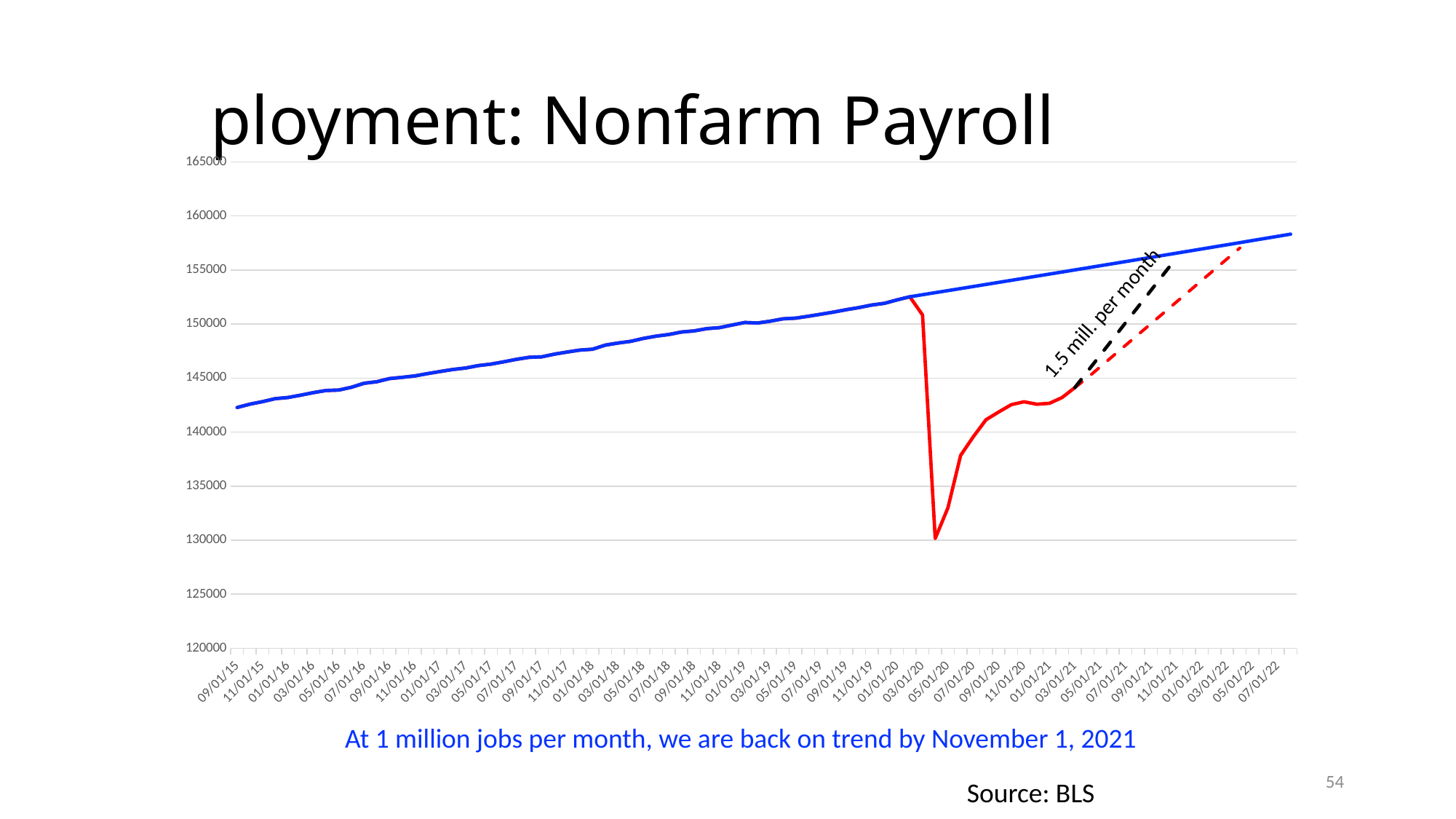
What source is cited below the chart? BLS Is the value of the red line at 01/01/21 greater or less than 145000? less Is the value of the blue line at 09/01/15 greater or less than 145000? less Which line reaches the lowest value on the chart, the blue line or the red line? the red line Does the blue line rise or fall from 09/01/15 to 07/01/22? rise Is the value of the blue line at 07/01/22 greater or less than 155000? greater What kind of chart is shown on the slide? line chart What rate is written next to the black dashed line on the chart? 1.5 mill. per month At 05/01/20, which line has the higher value, the blue line or the red line? the blue line